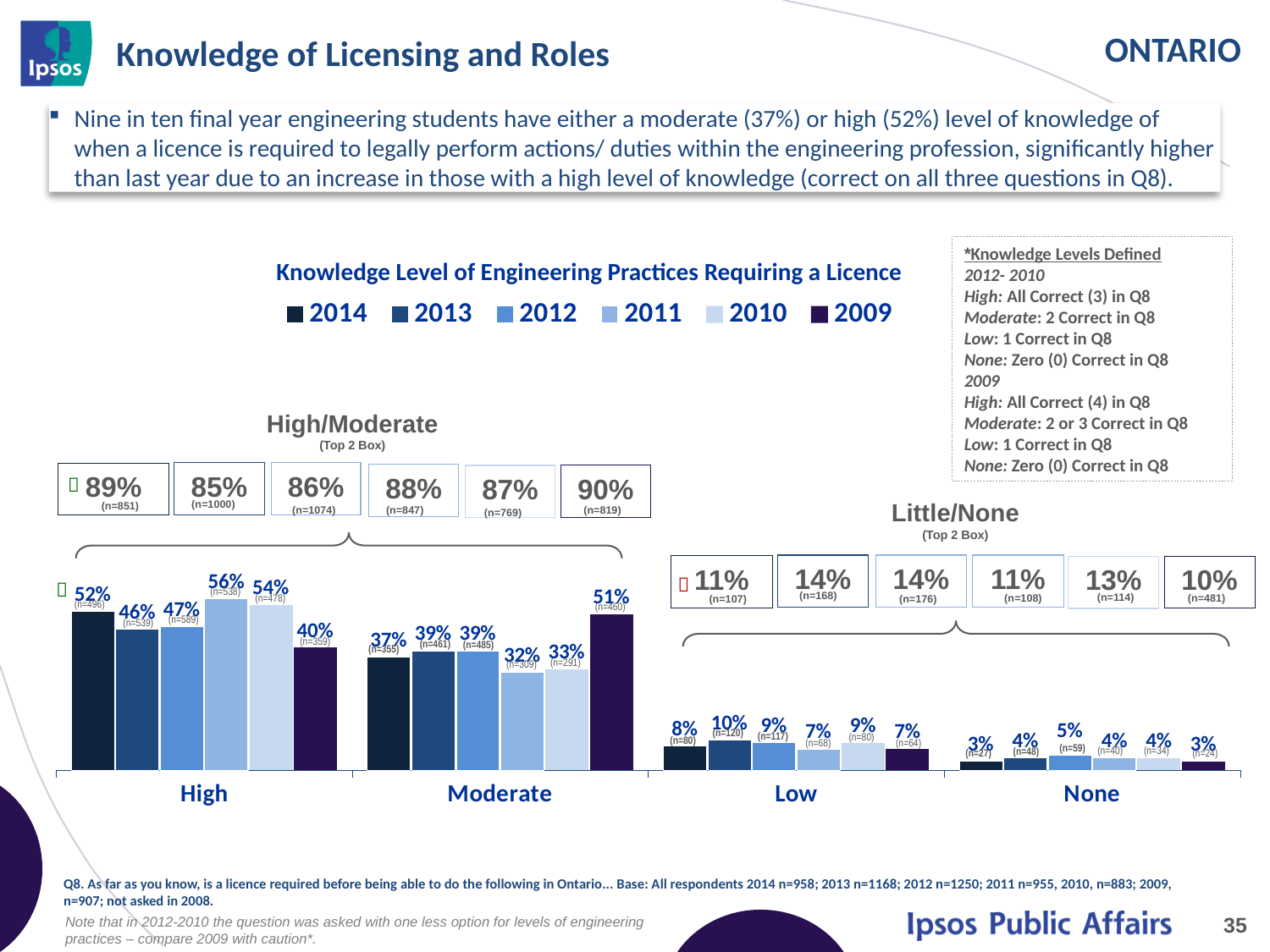
What kind of chart is shown on the slide? bar chart How many categories are shown on the x axis? 4 How many series does the legend list? 6 What is the value for 2012 in the None category? 5% Which is larger in the Moderate category, the 2014 value or the 2009 value? 2009 What is the title of the chart? Knowledge Level of Engineering Practices Requiring a Licence What is the difference between the 2011 and 2009 values in the High category? 16% What is the value for 2014 in the High category? 52% What is the value for 2009 in the Moderate category? 51% Which year has the highest value in the High category? 2011 What is the difference between the 2013 and 2011 values in the Low category? 3% Which year has the lowest value in the High category? 2009